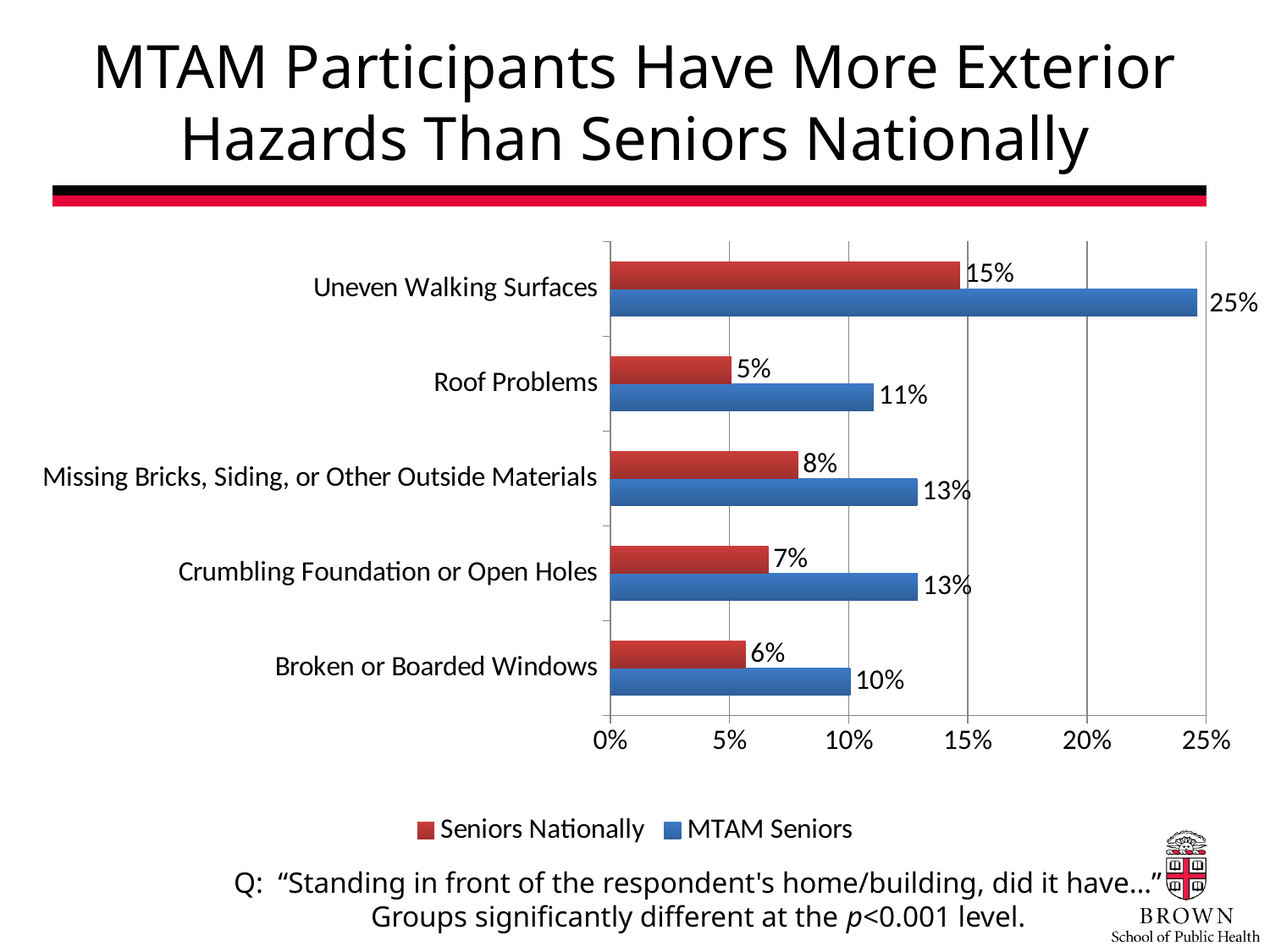
Which is larger for Crumbling Foundation or Open Holes: Seniors Nationally or MTAM Seniors? MTAM Seniors What kind of chart is shown on the slide? Bar chart How many categories are shown on the chart? 5 How many series does the legend list? 2 Which category has the lowest value for Seniors Nationally? Roof Problems What colour are the bars for Seniors Nationally? Red What is the value for Seniors Nationally for Roof Problems? 5% What is the value for MTAM Seniors for Broken or Boarded Windows? 10% What is the difference between MTAM Seniors and Seniors Nationally for Uneven Walking Surfaces? 10% Is the value for MTAM Seniors for Roof Problems greater or less than 10%? greater Which category has the highest value for MTAM Seniors? Uneven Walking Surfaces What is the value for MTAM Seniors for Uneven Walking Surfaces? 25%